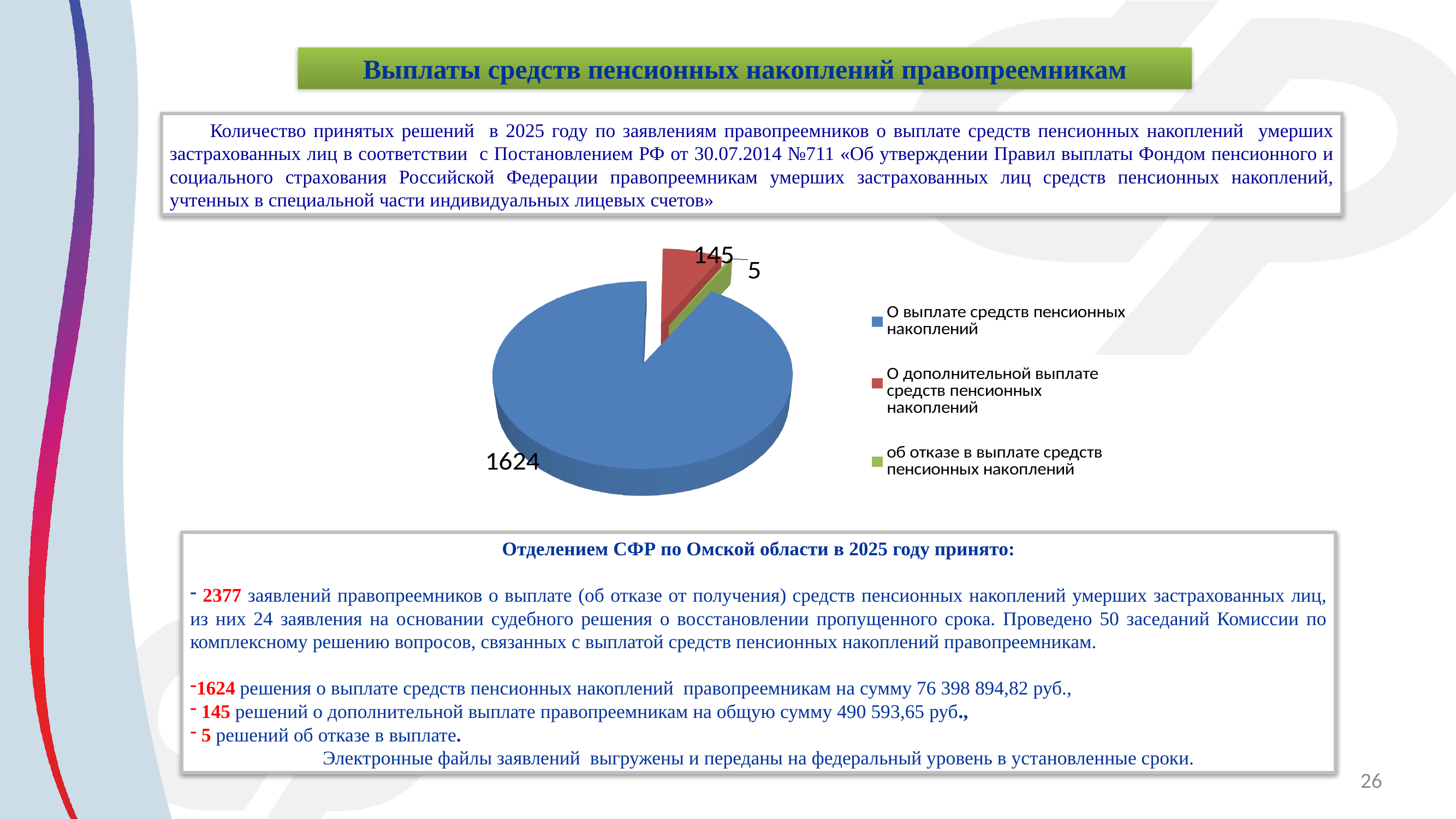
What is the total of all slices in the pie chart? 1774 How many slices does the pie chart have? 3 How many entries does the legend of the pie chart list? 3 What type of chart is shown on the slide? Pie chart What colour is the slice for "об отказе в выплате средств пенсионных накоплений"? Green What is the value of the slice "О выплате средств пенсионных накоплений"? 1624 Which category has the smallest slice in the pie chart? об отказе в выплате средств пенсионных накоплений What is the difference between the values for "О выплате средств пенсионных накоплений" and "О дополнительной выплате средств пенсионных накоплений"? 1479 What is the value of the slice "О дополнительной выплате средств пенсионных накоплений"? 145 Which category has the largest slice in the pie chart? О выплате средств пенсионных накоплений What is the value of the slice "об отказе в выплате средств пенсионных накоплений"? 5 Which is larger: the value for "О дополнительной выплате средств пенсионных накоплений" or the value for "об отказе в выплате средств пенсионных накоплений"? О дополнительной выплате средств пенсионных накоплений